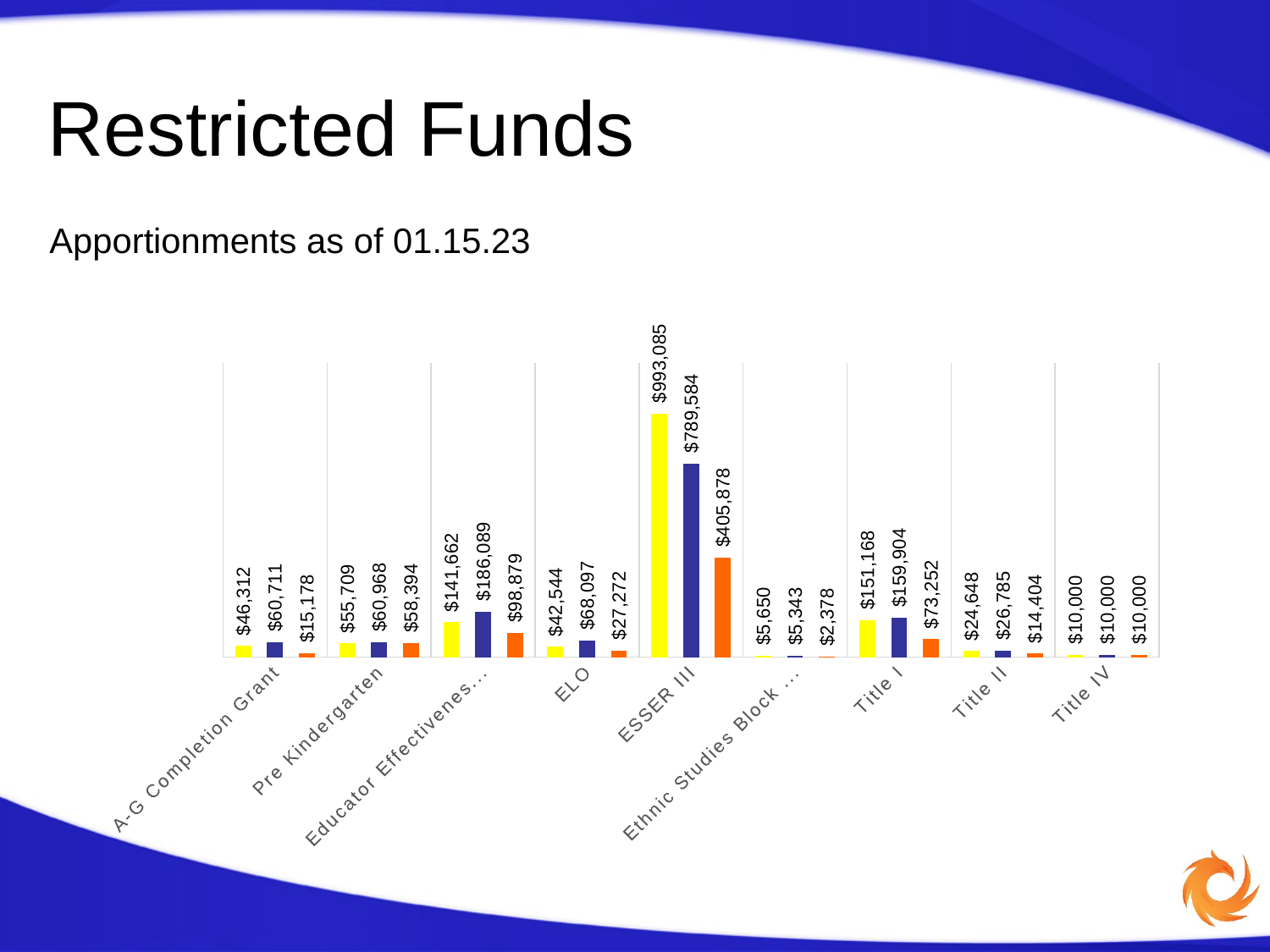
Which category has the highest yellow bar? ESSER III What is the value of the yellow bar for ESSER III? $993,085 What kind of chart is shown on the slide? bar chart What is the value of the yellow bar for Pre Kindergarten? $55,709 What is the subtitle text shown above the chart? Apportionments as of 01.15.23 What is the value of the orange bar for Title I? $73,252 What is the value of the dark blue bar for ELO? $68,097 Which is larger for Title II, the yellow bar or the dark blue bar? the dark blue bar What is the difference between the dark blue and orange bars for A-G Completion Grant? $45,533 Which category has the lowest orange bar? Ethnic Studies Block What is the difference between the yellow and dark blue bars for ESSER III? $203,501 How many categories are shown on the x axis? 9